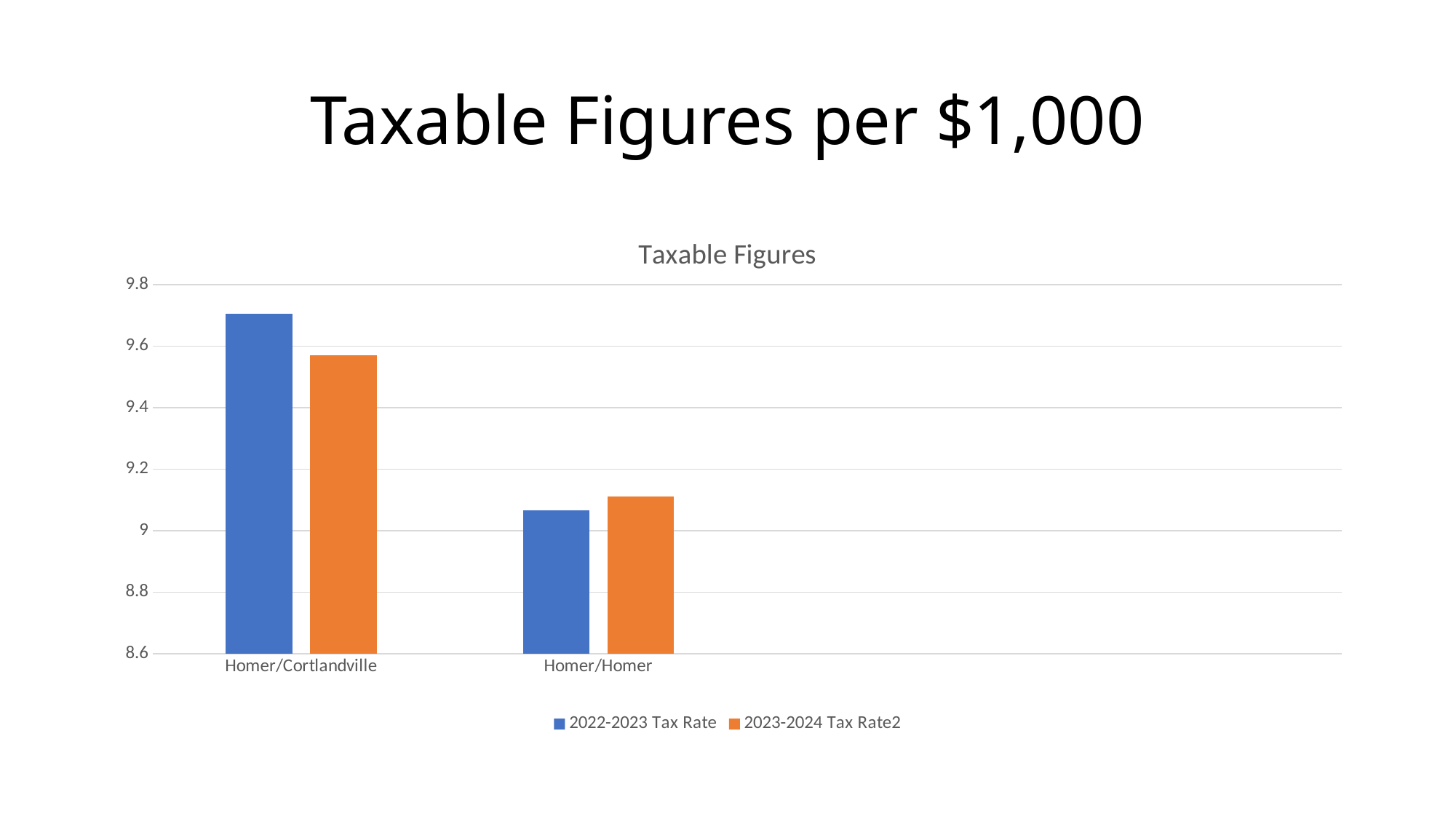
Is the 2023-2024 Tax Rate2 for Homer/Homer greater or less than 9.2? less Which category has the lowest 2023-2024 Tax Rate2? Homer/Homer How many categories are shown on the x axis? 2 For Homer/Homer, which is larger: the 2022-2023 Tax Rate or the 2023-2024 Tax Rate2? 2023-2024 Tax Rate2 What is the title of the chart? Taxable Figures Which category has the highest 2022-2023 Tax Rate? Homer/Cortlandville How many series does the legend list? 2 What kind of chart is shown on the slide? bar chart Is the 2022-2023 Tax Rate for Homer/Homer greater or less than 9? greater Which series is shown in orange? 2023-2024 Tax Rate2 Is the 2022-2023 Tax Rate for Homer/Cortlandville greater or less than 9.6? greater For Homer/Cortlandville, which is larger: the 2022-2023 Tax Rate or the 2023-2024 Tax Rate2? 2022-2023 Tax Rate